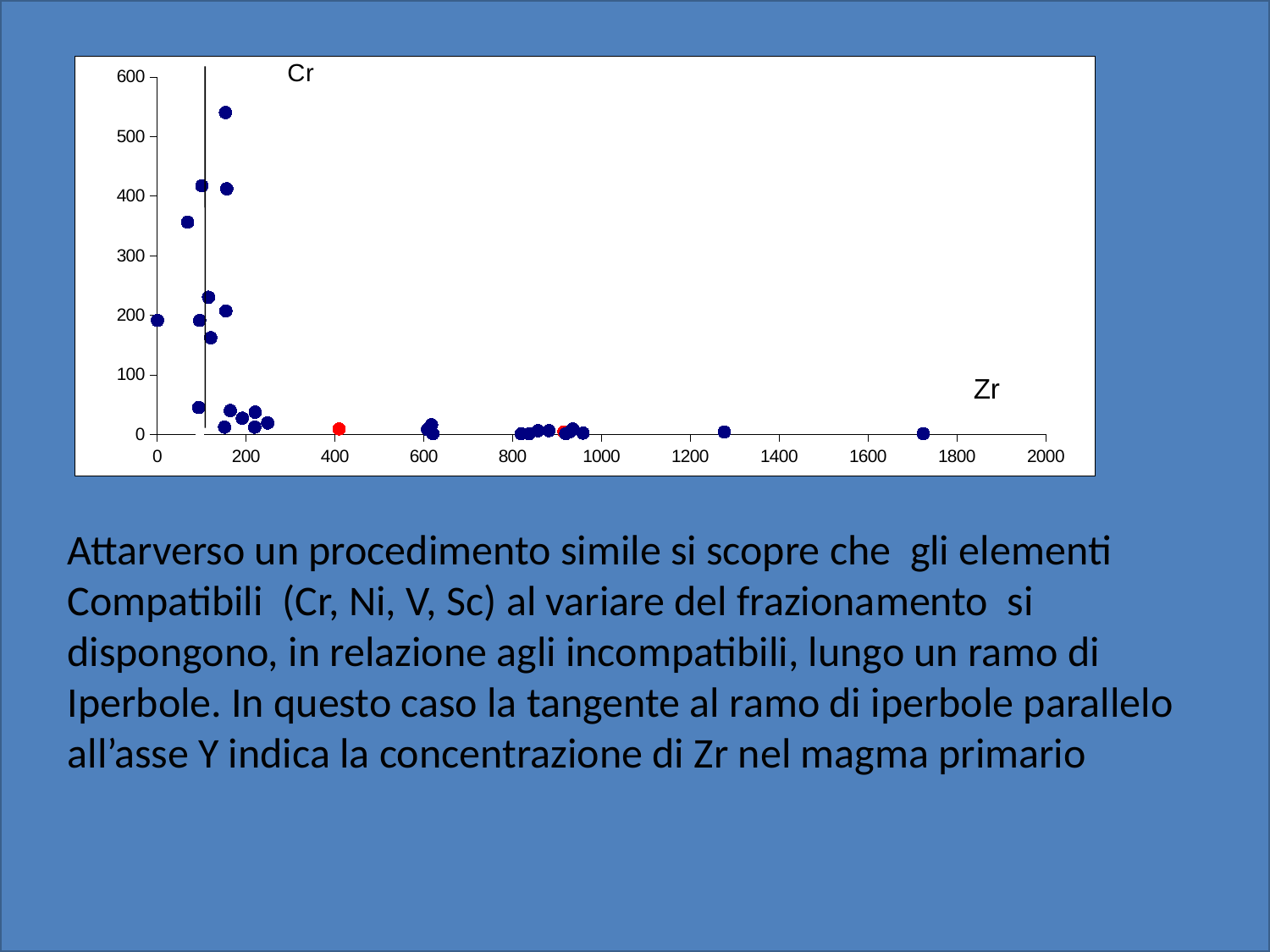
Is the Cr value of the rightmost point on the chart greater or less than 100? less Do the Cr values generally rise or fall as Zr increases along the x axis? fall What label is shown on the horizontal axis of the chart? Zr Is the Cr value of the leftmost point (at Zr near 0) greater or less than 100? greater What label is shown on the vertical axis of the chart? Cr Is the Cr value of the red point near Zr = 400 greater or less than 100? less What kind of chart is shown on the slide? scatter plot Which has the higher Cr value: the point at Zr near 1280 or the highest point near Zr 150? the point near Zr 150